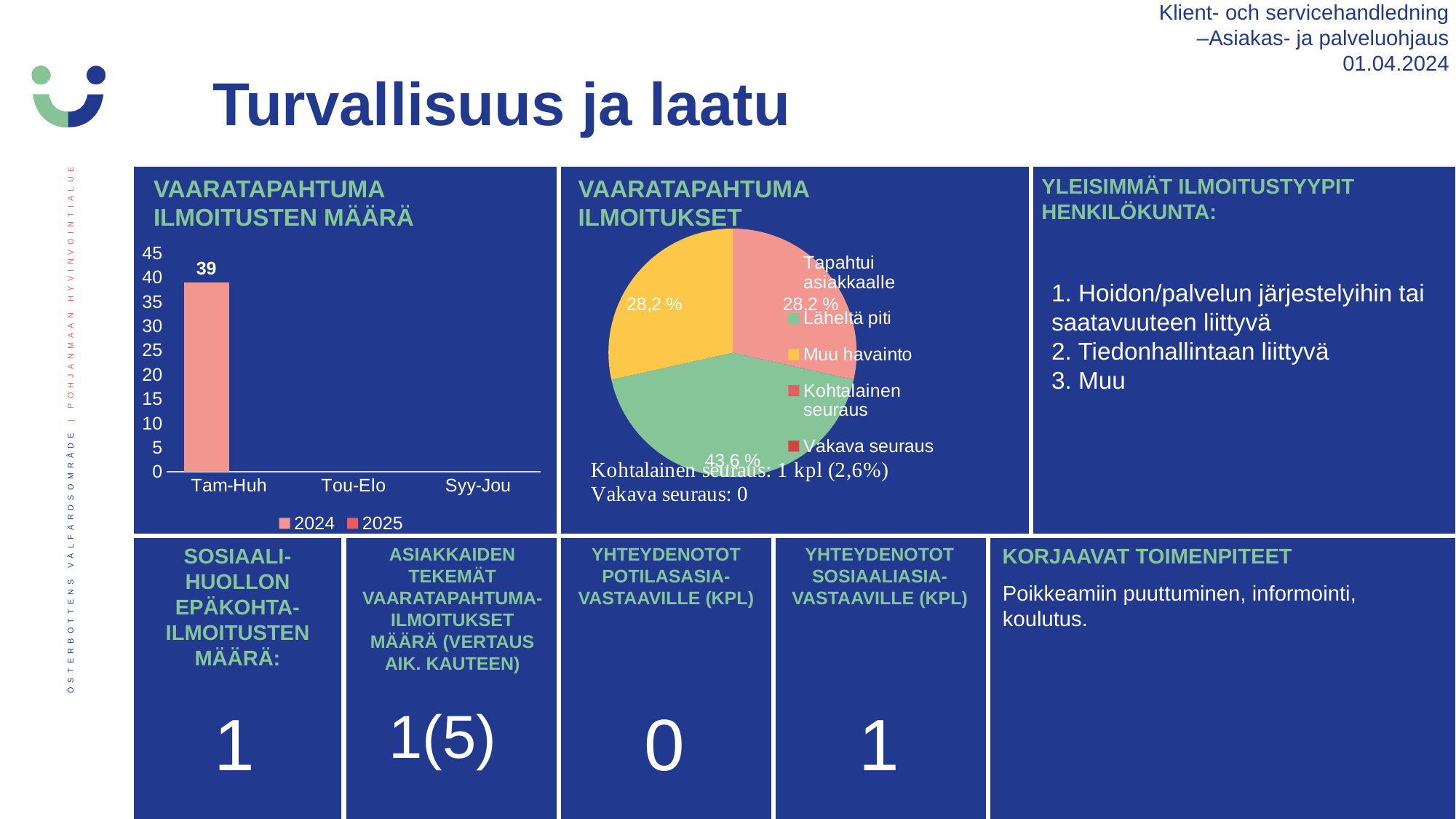
How many entries does the legend of the 'VAARATAPAHTUMA ILMOITUKSET' pie chart list? 5 What kind of chart is the 'VAARATAPAHTUMA ILMOITUKSET' chart? pie chart What kind of chart is the 'VAARATAPAHTUMA ILMOITUSTEN MÄÄRÄ' chart? bar chart How many series does the legend of the 'VAARATAPAHTUMA ILMOITUSTEN MÄÄRÄ' chart list? 2 How many categories are on the x axis of the 'VAARATAPAHTUMA ILMOITUSTEN MÄÄRÄ' chart? 3 In the 'VAARATAPAHTUMA ILMOITUSTEN MÄÄRÄ' chart, what value is shown for Tam-Huh? 39 In the 'VAARATAPAHTUMA ILMOITUKSET' pie chart, which category has the largest slice? Läheltä piti In the 'VAARATAPAHTUMA ILMOITUKSET' pie chart, which is larger: 'Läheltä piti' or 'Tapahtui asiakkaalle'? Läheltä piti In the 'VAARATAPAHTUMA ILMOITUKSET' pie chart, what share does 'Muu havainto' have? 28,2 % In the 'VAARATAPAHTUMA ILMOITUKSET' pie chart, what is the difference in percentage points between 'Läheltä piti' and 'Muu havainto'? 15,4 In the 'VAARATAPAHTUMA ILMOITUKSET' pie chart, what share does 'Läheltä piti' have? 43,6 % In the 'VAARATAPAHTUMA ILMOITUSTEN MÄÄRÄ' chart, is the value for Tam-Huh greater or less than 35? greater